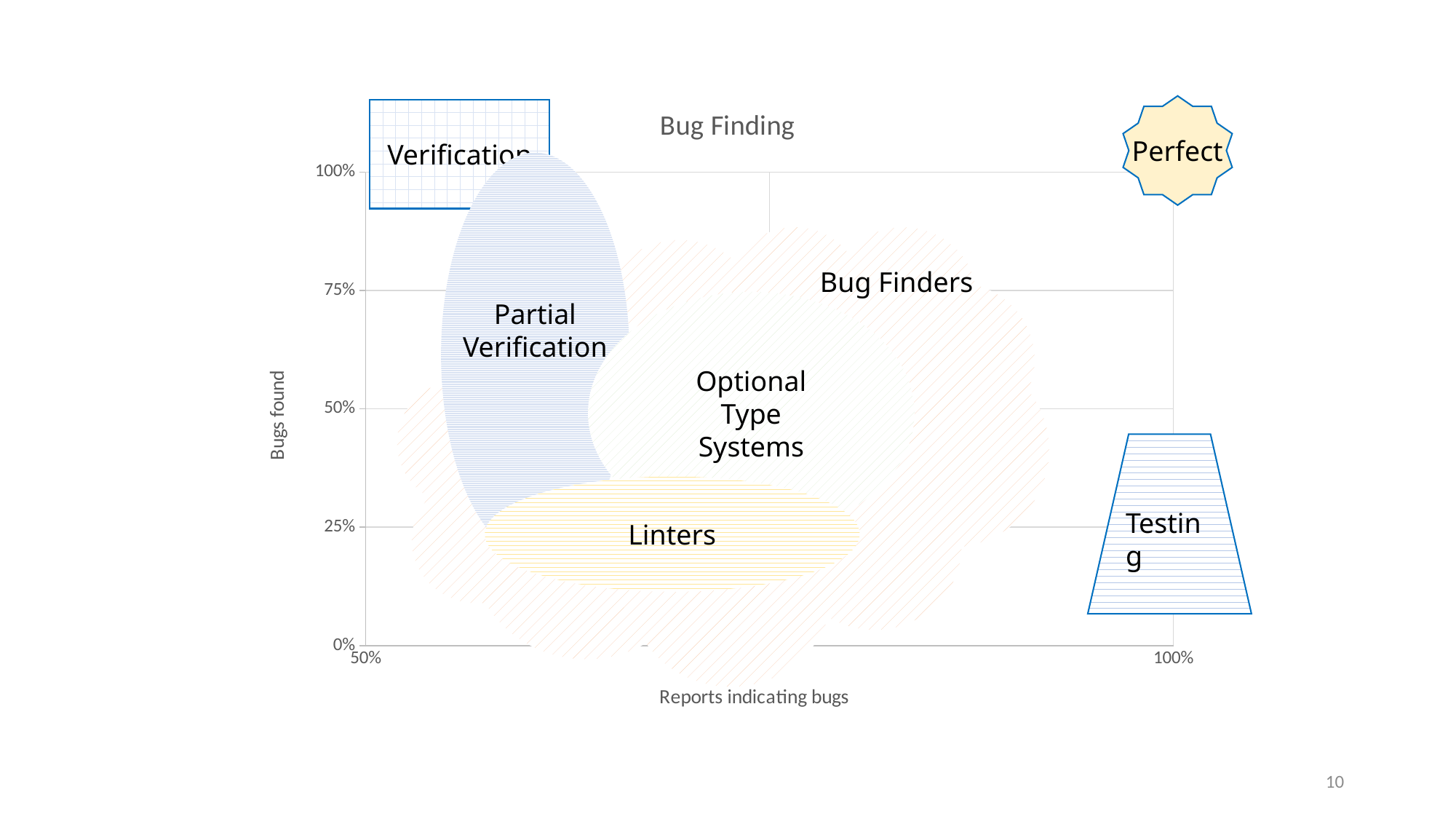
What is the title of the chart? Bug Finding Which labelled shape sits at the top-right corner of the chart, near 100% bugs found and 100% reports indicating bugs? Perfect What is the lowest value labelled on the horizontal axis? 50% Is the Testing shape closer to 50% or to 100% on the Reports indicating bugs axis? 100% How many labelled regions or shapes are placed on the chart? 7 Is the Linters region located above or below 50% on the Bugs found axis? below What is the highest value labelled on the vertical axis? 100% What is the label of the vertical axis? Bugs found Is the Testing shape located above or below 50% on the Bugs found axis? below Which labelled region is placed at the top-left of the chart, near 100% bugs found and 50% reports indicating bugs? Verification What is the label of the horizontal axis? Reports indicating bugs